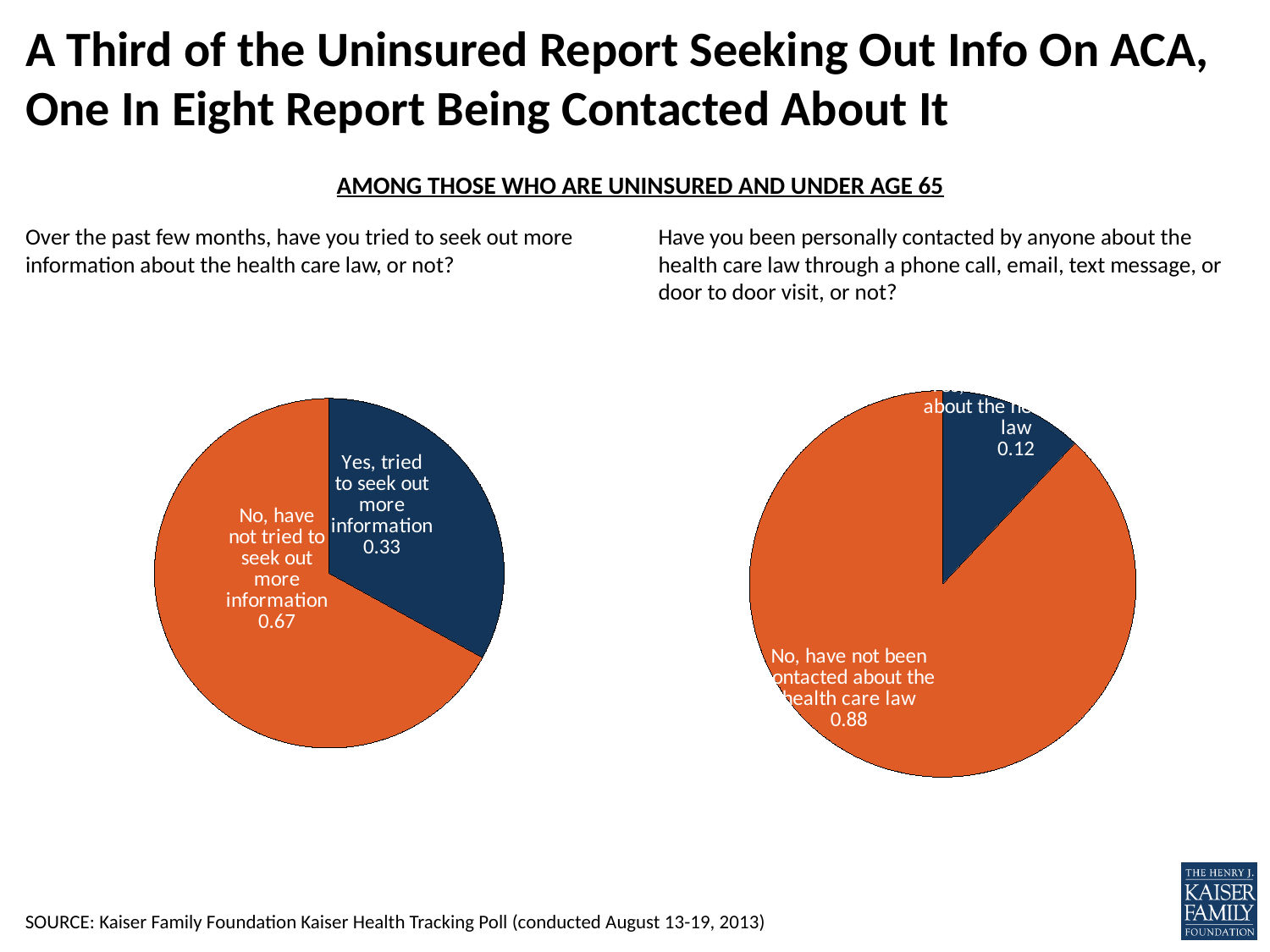
On the right pie chart, what value is shown for the smaller slice, those who have been contacted about the health care law? 0.12 On the right pie chart, what value is shown for 'No, have not been contacted about the health care law'? 0.88 What colour is the 'No, have not been contacted about the health care law' slice on the right pie chart? Orange How many slices does the right pie chart have? 2 On the right pie chart, which slice is the smallest? The 'Yes' slice (contacted about the health care law), 0.12 What type of chart is used on the left side of the slide? Pie chart On the left pie chart, which slice is the largest? No, have not tried to seek out more information Which is larger on the left pie chart: the share who tried to seek out more information or the share who did not? The share who did not (0.67) On the right pie chart, what is the difference between the 'No, have not been contacted' share and the contacted share? 0.76 On the left pie chart, what share of the uninsured said they tried to seek out more information about the health care law? 0.33 On the left pie chart, what value is shown for 'No, have not tried to seek out more information'? 0.67 On the left pie chart, what is the difference between the 'No' share and the 'Yes' share? 0.34